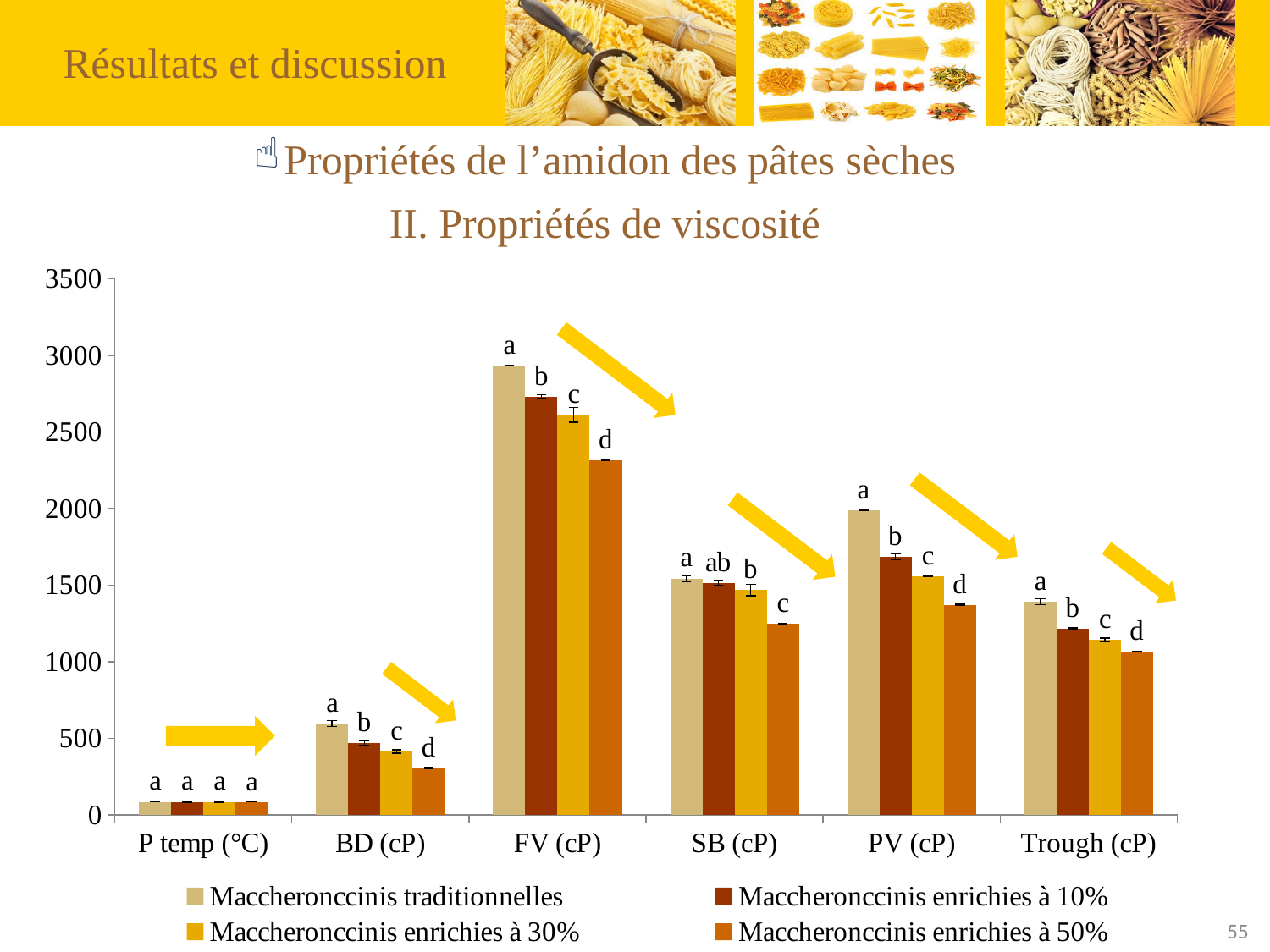
In FV (cP), which is larger: Maccheronccinis traditionnelles or Maccheronccinis enrichies à 50%? Maccheronccinis traditionnelles What kind of chart is shown on the slide? bar chart How many categories are shown on the x axis of the chart? 6 Which category has the highest bar for Maccheronccinis traditionnelles? FV (cP) How many series does the chart legend list? 4 Is the value for Maccheronccinis traditionnelles in FV (cP) greater or less than 2500? greater Is the value for Maccheronccinis traditionnelles in BD (cP) greater or less than 500? greater In PV (cP), do the values rise or fall going from Maccheronccinis traditionnelles to Maccheronccinis enrichies à 50%? fall Is the value for Maccheronccinis enrichies à 50% in SB (cP) greater or less than 1500? less Which legend entry is shown with the lightest (beige) colour? Maccheronccinis traditionnelles Which category has the lowest bars overall? P temp (°C)